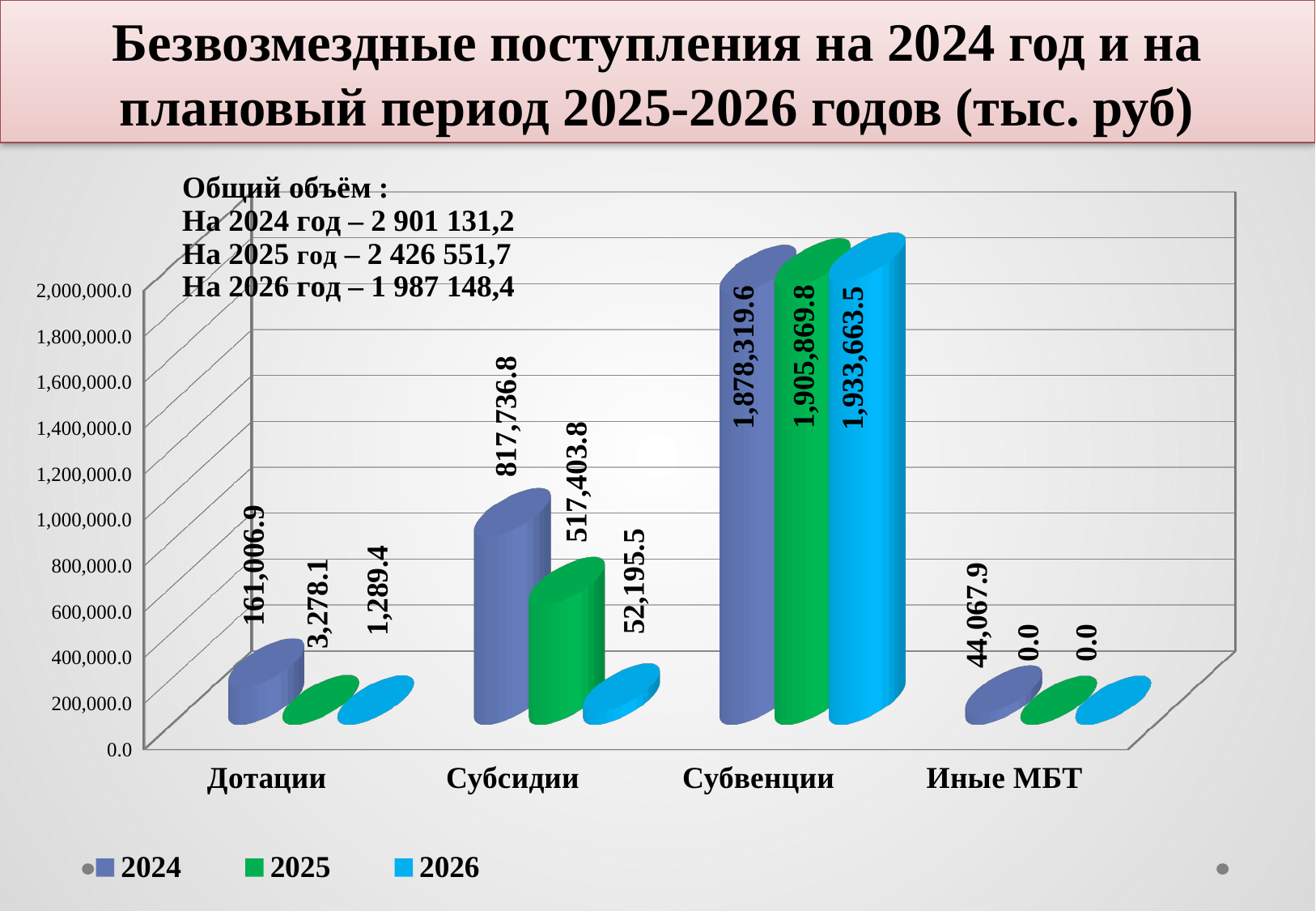
Which category has the lowest value in the 2026 series? Иные МБТ Which category has the highest value in the 2024 series? Субвенции What is the value for Субсидии in the 2024 series? 817,736.8 What is the value for Дотации in the 2025 series? 3,278.1 What is the value for Субвенции in the 2026 series? 1,933,663.5 What is the value for Иные МБТ in the 2024 series? 44,067.9 Do the values for Субвенции rise or fall from 2024 to 2026? Rise What kind of chart is shown on the slide? Bar chart What is the difference between the 2024 and 2025 values for Субсидии? 300,333.0 How many categories are shown on the x axis? 4 How many series does the legend list? 3 Which is larger: the 2024 value for Дотации or the 2026 value for Субсидии? 2024 value for Дотации